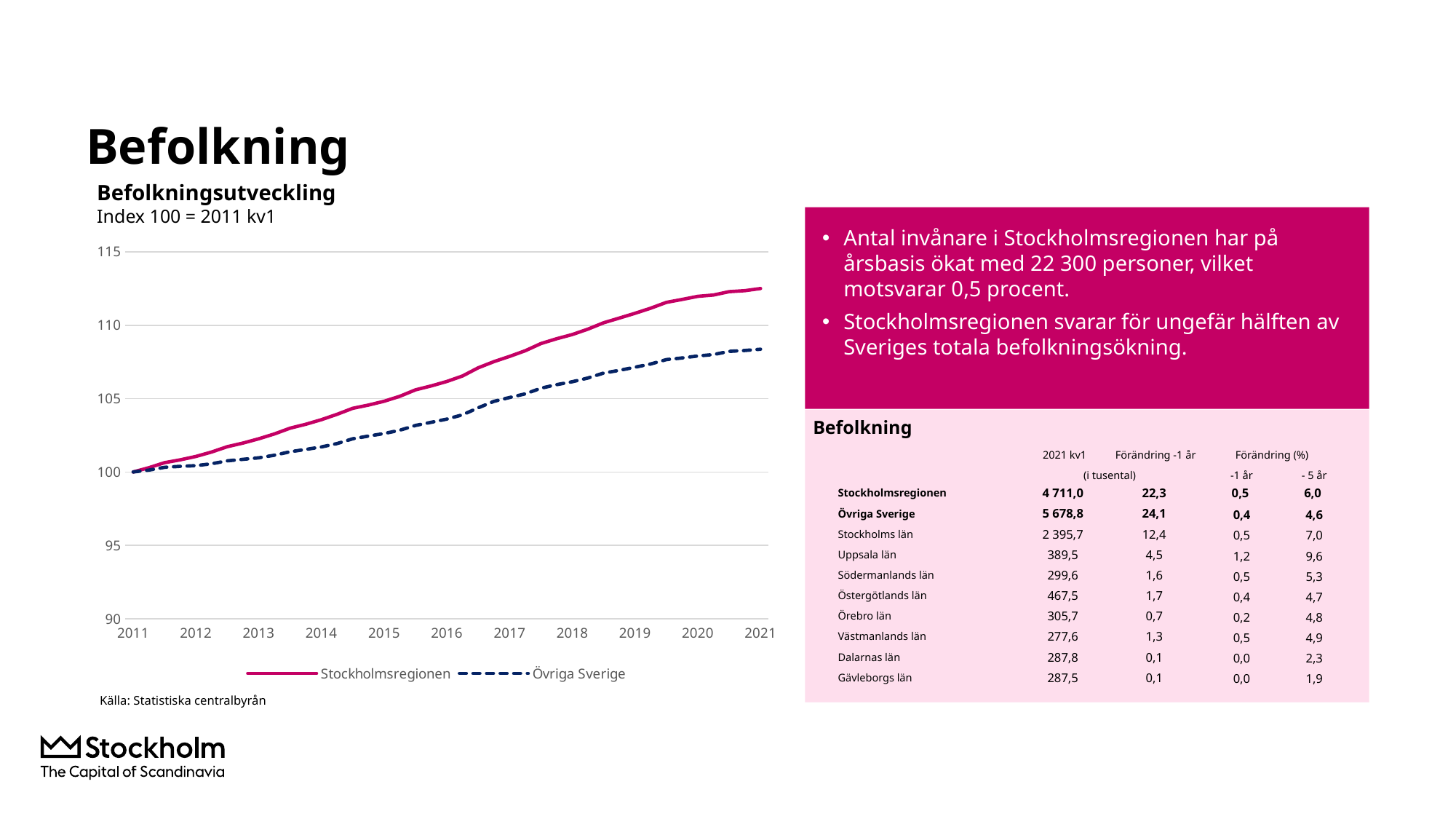
How many years are labelled on the x axis of the Befolkningsutveckling chart? 11 In the Befolkningsutveckling chart, is the value for Stockholmsregionen in 2018 greater or less than 105? greater How many series does the legend of the Befolkningsutveckling chart list? 2 What is the index value for Övriga Sverige in 2011 in the Befolkningsutveckling chart? 100 In the Befolkningsutveckling chart, which series has the higher value in 2021, Stockholmsregionen or Övriga Sverige? Stockholmsregionen In the Befolkningsutveckling chart, is the value for Övriga Sverige in 2016 greater or less than 105? less What kind of chart is the Befolkningsutveckling chart? line chart What are the two series shown in the Befolkningsutveckling chart? Stockholmsregionen and Övriga Sverige In the Befolkningsutveckling chart, do the values for Stockholmsregionen rise or fall from 2011 to 2021? rise In the Befolkningsutveckling chart, is the value for Stockholmsregionen in 2021 greater or less than 110? greater What is the index value for Stockholmsregionen in 2011 in the Befolkningsutveckling chart? 100